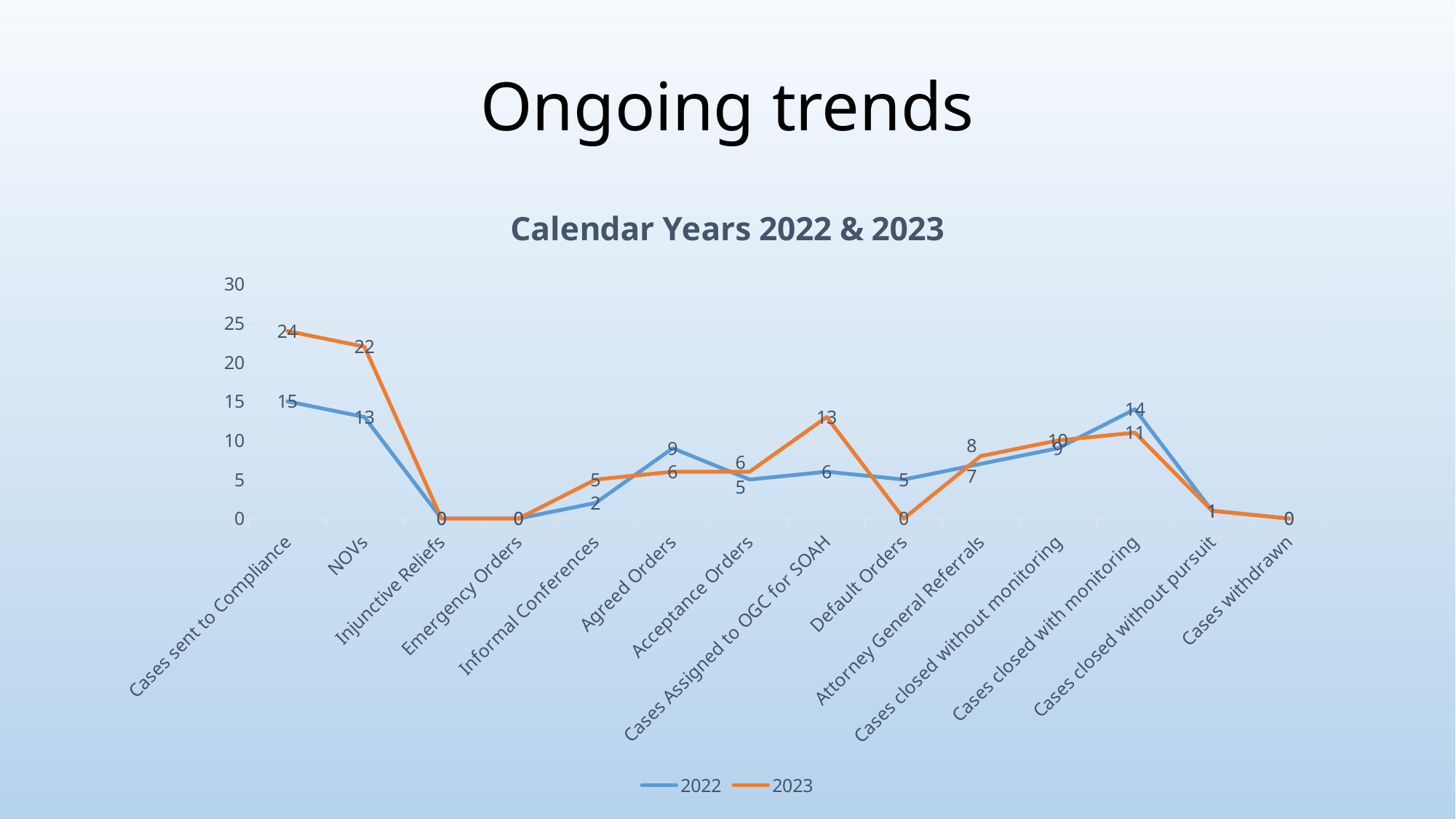
Which category has the highest 2023 value? Cases sent to Compliance What is the 2022 value for Cases closed with monitoring? 14 How many series does the legend list? 2 Which is larger for Agreed Orders, the 2022 value or the 2023 value? 2022 What type of chart is shown on the slide? Line chart What is the 2023 value for Cases sent to Compliance? 24 What is the 2022 value for NOVs? 13 Which category has the highest 2022 value? Cases sent to Compliance What is the 2023 value for Cases Assigned to OGC for SOAH? 13 How many categories are plotted along the x axis? 14 What is the difference between the 2023 and 2022 values for NOVs? 9 What is the title of the chart? Calendar Years 2022 & 2023